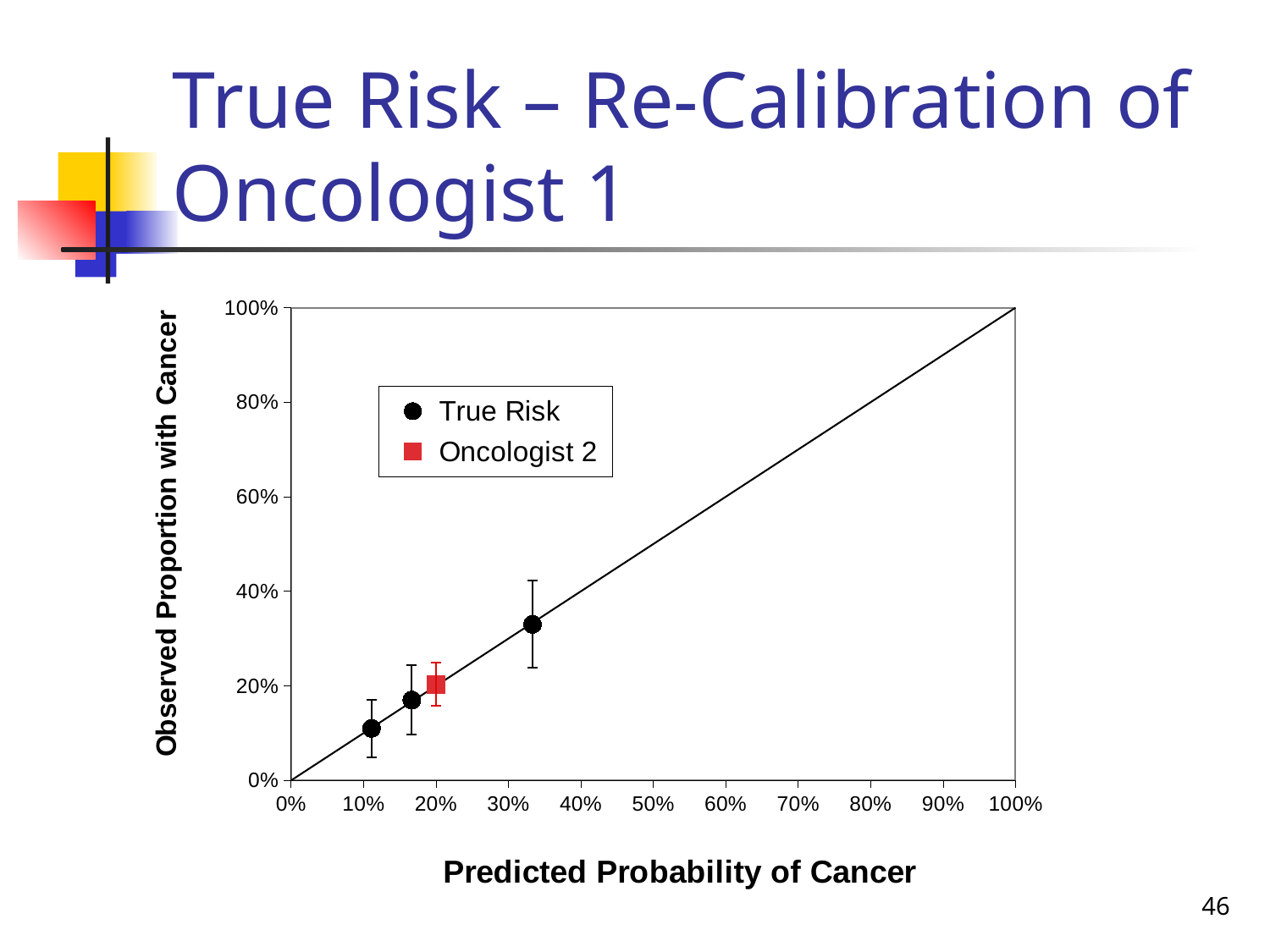
Is the predicted probability for the Oncologist 2 point greater or less than 30%? less Is the observed proportion for the highest True Risk point greater or less than 20%? greater Is the predicted probability for the lowest True Risk point greater or less than 20%? less What kind of chart is shown on the slide? scatter chart How many True Risk points are plotted? 3 Which series contains the point with the highest predicted probability of cancer? True Risk How many series does the legend list? 2 What are the two series named in the legend? True Risk and Oncologist 2 How many Oncologist 2 points are plotted? 1 As predicted probability increases along the x axis, does the observed proportion with cancer rise or fall? rise What is the title of the x axis? Predicted Probability of Cancer